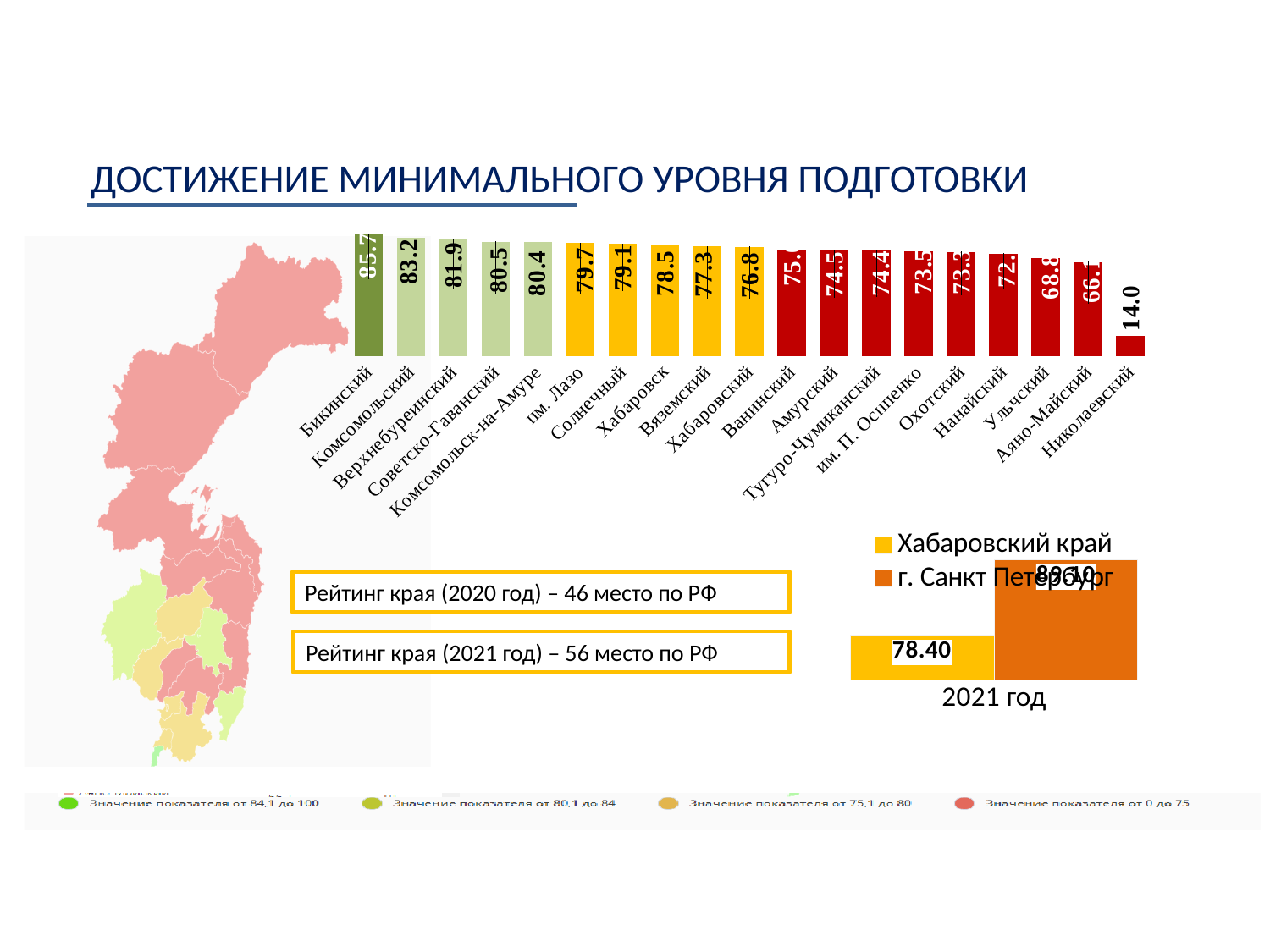
How many districts are shown in the top bar chart? 19 In the bottom-right chart for 2021 год, what is the value for Хабаровский край? 78.40 In the top bar chart of districts, what is the value for Николаевский? 14.0 In the top bar chart of districts, what is the value for Комсомольский? 83.2 In the top bar chart of districts, what is the difference between Верхнебуреинский and Советско-Гаванский? 1.4 In the top bar chart of districts, what is the value for им. П. Осипенко? 73.5 What type of chart is the bottom-right chart for 2021 год? bar chart In the top bar chart of districts, which is larger: им. Лазо or Вяземский? им. Лазо In the top bar chart of districts, which district has the lowest value? Николаевский How many series does the legend of the bottom-right chart list? 2 In the top bar chart of districts, what is the value for Хабаровск? 78.5 In the top bar chart of districts, which district has the highest value? Бикинский